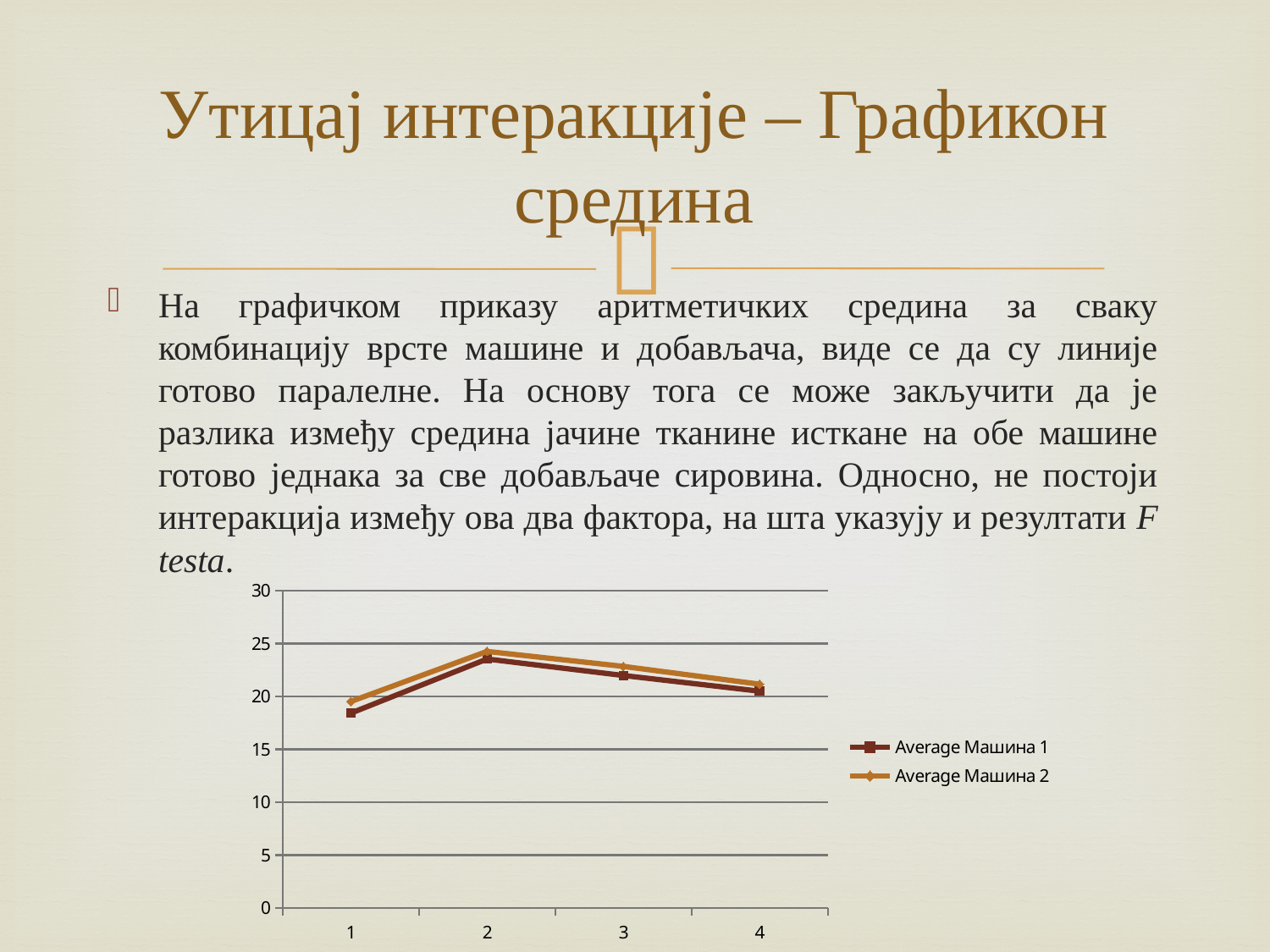
At category 1, which series has the larger value, Average Машина 1 or Average Машина 2? Average Машина 2 Is the value for Average Машина 2 at category 4 greater or less than 20? greater What kind of chart is shown on the slide? line chart What are the two entries listed in the chart legend? Average Машина 1 and Average Машина 2 Is the value for Average Машина 1 at category 2 greater or less than 20? greater Do the values of the Average Машина 1 line rise or fall from category 2 to category 4? fall At which x-axis category does the Average Машина 1 line reach its highest value? 2 At which x-axis category does the Average Машина 2 line reach its lowest value? 1 How many series does the chart legend list? 2 Is the value for Average Машина 1 at category 1 greater or less than 20? less How many categories are shown on the x axis of the chart? 4